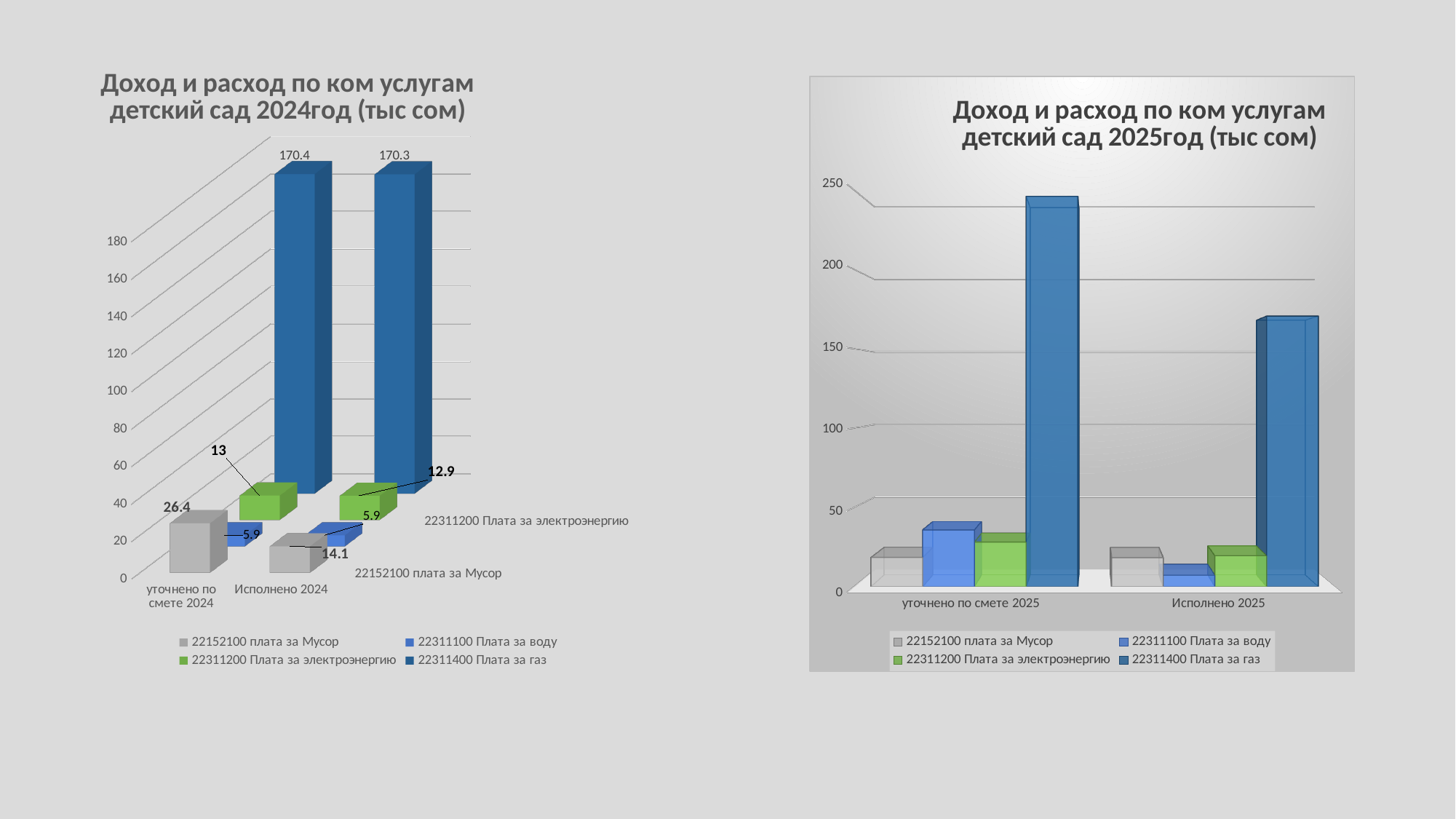
What kind of chart is the 2025 chart (right)? Bar chart In the 2025 chart (right), which category has the higher value for 22311400 Плата за газ? уточнено по смете 2025 In the 2024 chart (left), which series has the highest value in the 'Исполнено 2024' category? 22311400 Плата за газ In the 2024 chart (left), which is larger: 22311200 Плата за электроэнергию for 'уточнено по смете 2024' or for 'Исполнено 2024'? уточнено по смете 2024 In the 2025 chart (right), is the value for 22311400 Плата за газ in 'уточнено по смете 2025' greater or less than 200? greater In the 2024 chart (left), what is the value for 22311200 Плата за электроэнергию in the 'уточнено по смете 2024' category? 13 In the 2025 chart (right), is the value for 22311400 Плата за газ in 'Исполнено 2025' greater or less than 200? less In the 2024 chart (left), what is the value for 22152100 плата за Мусор in the 'Исполнено 2024' category? 14.1 In the 2024 chart (left), what is the difference between the 'уточнено по смете 2024' and 'Исполнено 2024' values for 22152100 плата за Мусор? 12.3 How many series does the legend of the 2025 chart (right) list? 4 In the 2024 chart (left), which series has the lowest value in the 'уточнено по смете 2024' category? 22311100 Плата за воду In the 2024 chart (left), what is the value for 22311400 Плата за газ in the 'уточнено по смете 2024' category? 170.4